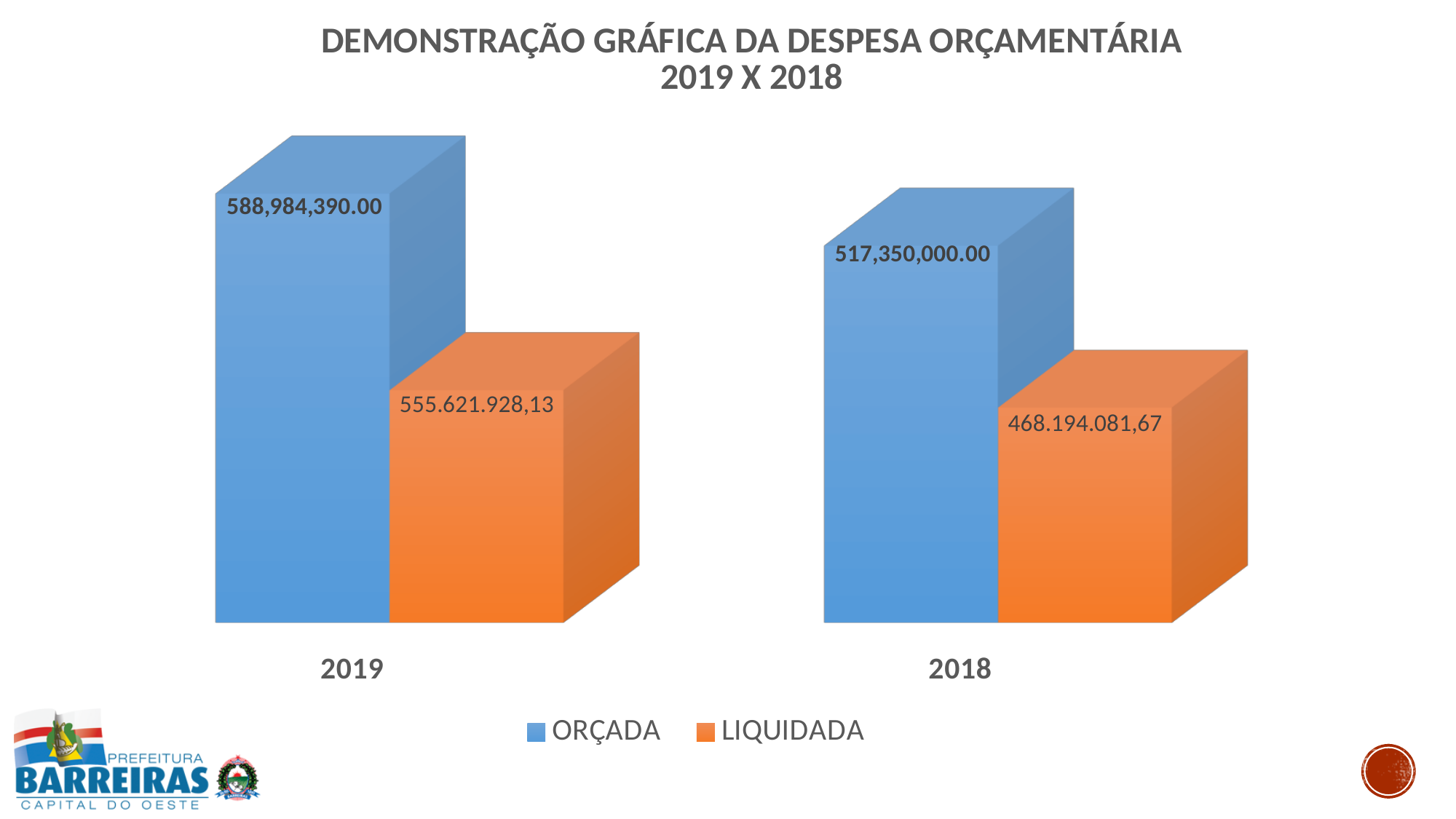
Which year has the higher ORÇADA value? 2019 How many series does the legend list? 2 Which year has the lower LIQUIDADA value? 2018 How many years are shown on the x axis? 2 What is the ORÇADA value for 2019? 588,984,390.00 What is the ORÇADA value for 2018? 517,350,000.00 In 2018, which is larger, ORÇADA or LIQUIDADA? ORÇADA What is the difference between the ORÇADA values for 2019 and 2018? 71,634,390.00 What is the LIQUIDADA value for 2018? 468.194.081,67 Which colour represents the LIQUIDADA series? Orange What kind of chart is shown on the slide? Bar chart What is the LIQUIDADA value for 2019? 555.621.928,13